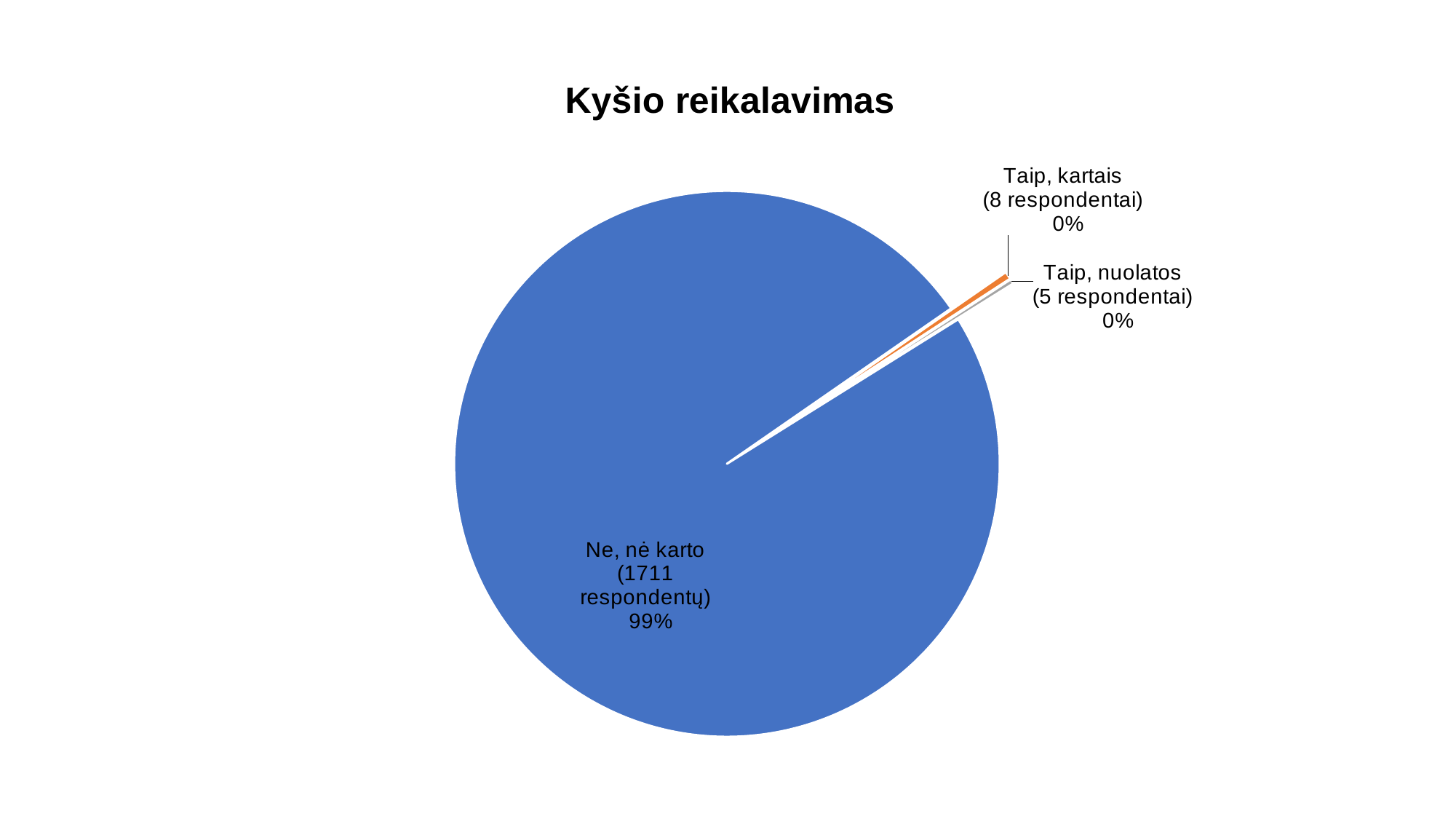
What percentage is shown for "Taip, kartais"? 0% How many respondents answered "Taip, kartais"? 8 What is the difference in respondents between "Taip, kartais" and "Taip, nuolatos"? 3 What share of the pie does "Ne, nė karto" represent? 99% Which has more respondents, "Taip, kartais" or "Taip, nuolatos"? Taip, kartais Which category has the largest slice? Ne, nė karto Which category has the fewest respondents? Taip, nuolatos What kind of chart is shown on the slide? pie chart How many respondents answered "Ne, nė karto"? 1711 What is the title of the chart? Kyšio reikalavimas How many respondents answered "Taip, nuolatos"? 5 How many slices does the pie chart have? 3